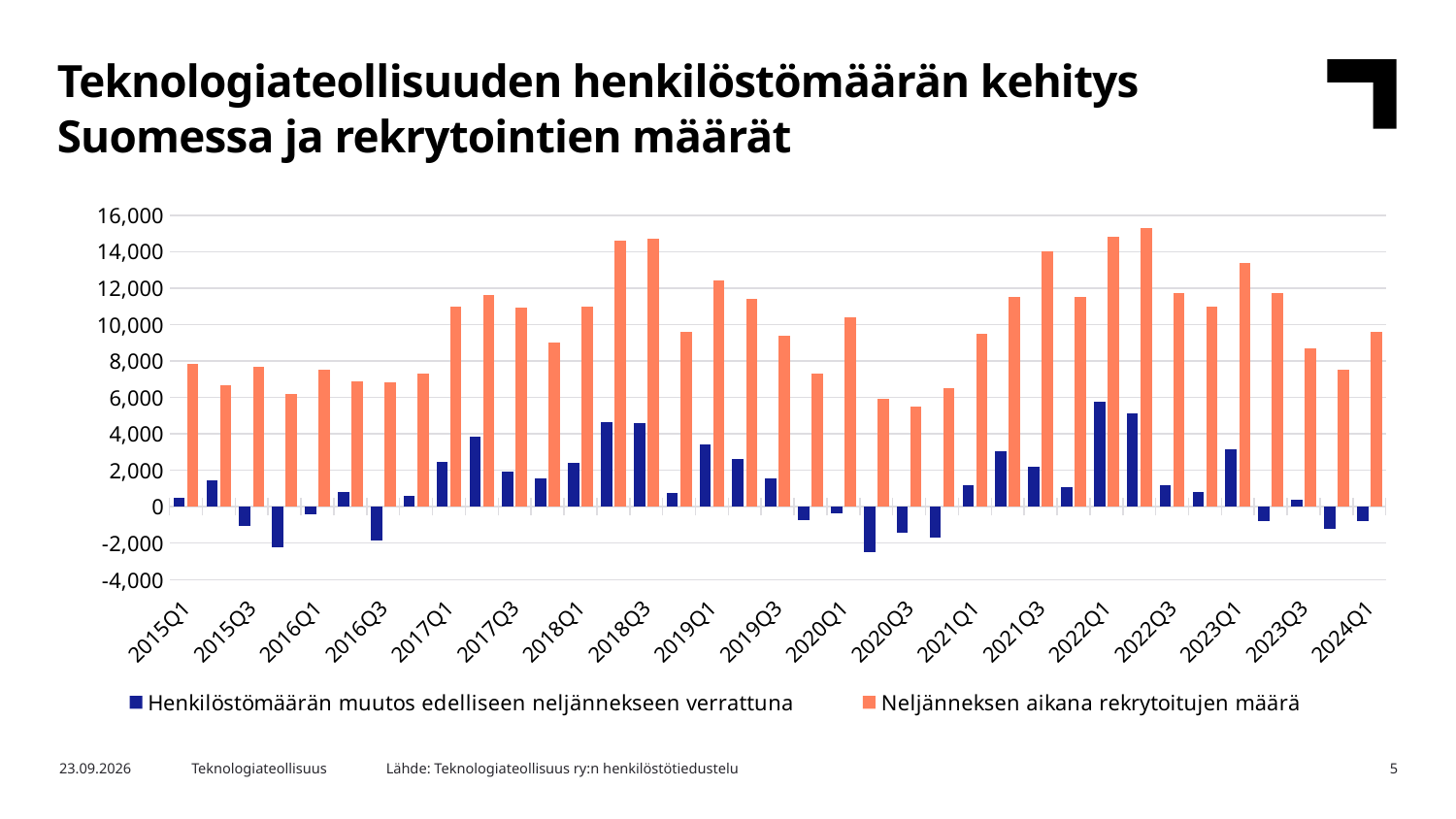
Is the value for 'Henkilöstömäärän muutos edelliseen neljännekseen verrattuna' in 2016Q1 greater or less than 0? less In which quarter is the value for 'Neljänneksen aikana rekrytoitujen määrä' highest? 2022Q2 Is the value for 'Henkilöstömäärän muutos edelliseen neljännekseen verrattuna' in 2022Q1 greater or less than 4,000? greater What is the title of the chart on the slide? Teknologiateollisuuden henkilöstömäärän kehitys Suomessa ja rekrytointien määrät Which quarter has the larger value for 'Neljänneksen aikana rekrytoitujen määrä', 2018Q3 or 2019Q3? 2018Q3 What kind of chart is shown on the slide? Bar chart Is the value for 'Neljänneksen aikana rekrytoitujen määrä' in 2020Q3 greater or less than 6,000? less In which quarter is the value for 'Neljänneksen aikana rekrytoitujen määrä' lowest? 2020Q3 How many series does the legend list? 2 Which series is shown in orange according to the legend? Neljänneksen aikana rekrytoitujen määrä In which quarter is the value for 'Henkilöstömäärän muutos edelliseen neljännekseen verrattuna' highest? 2022Q1